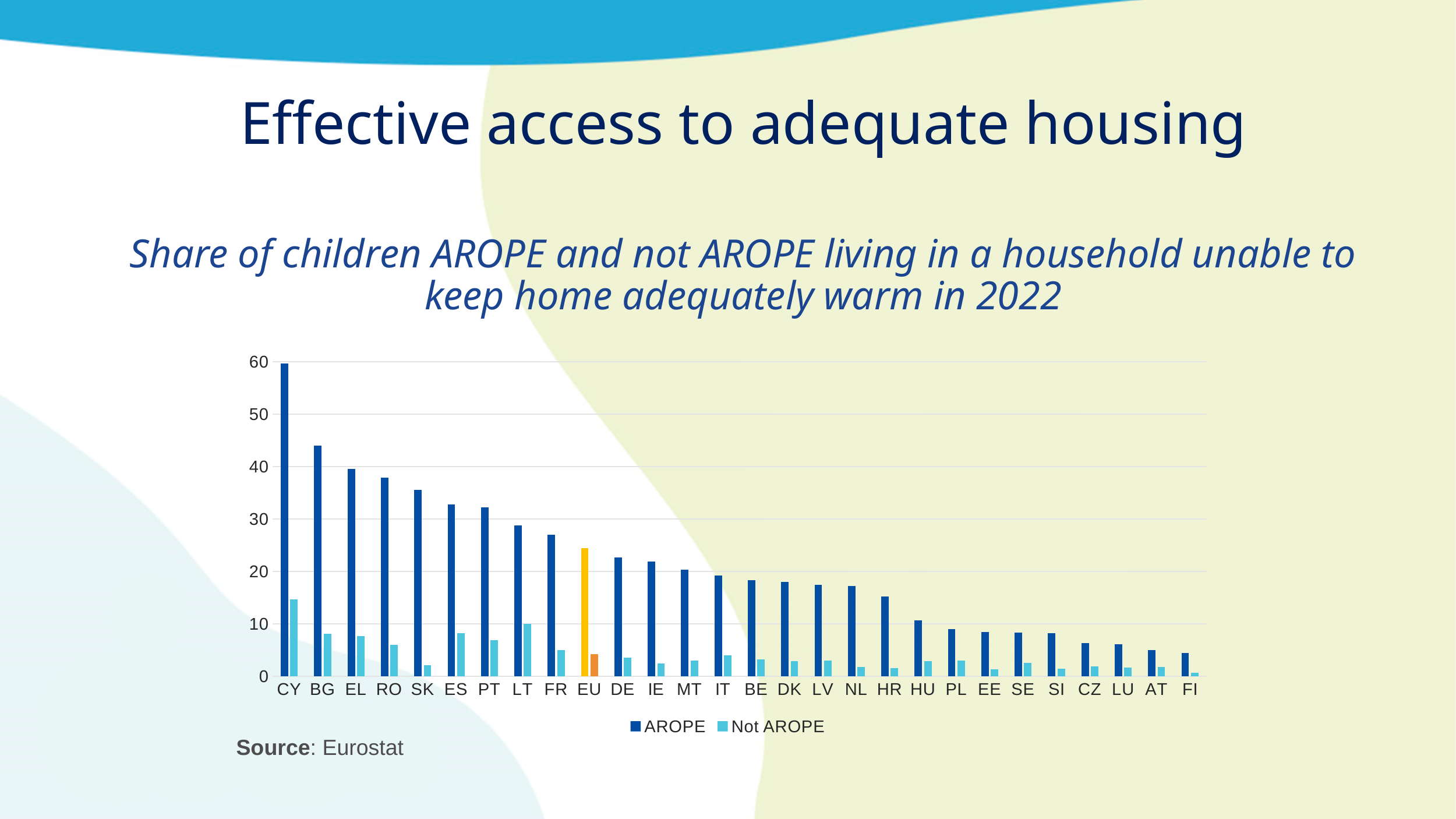
Which category has the highest Not AROPE value? CY Is the AROPE value for SK greater or less than 40? less Do the AROPE values rise or fall moving from left to right along the x axis? fall What kind of chart is shown on the slide? bar chart Is the AROPE value for EU greater or less than 20? greater Which is larger, the AROPE value for BG or the AROPE value for EL? BG How many series does the legend list? 2 Which category has the lowest AROPE value? FI Which category has the highest AROPE value? CY Is the AROPE value for CY greater or less than 50? greater How many countries/categories are shown on the x axis? 28